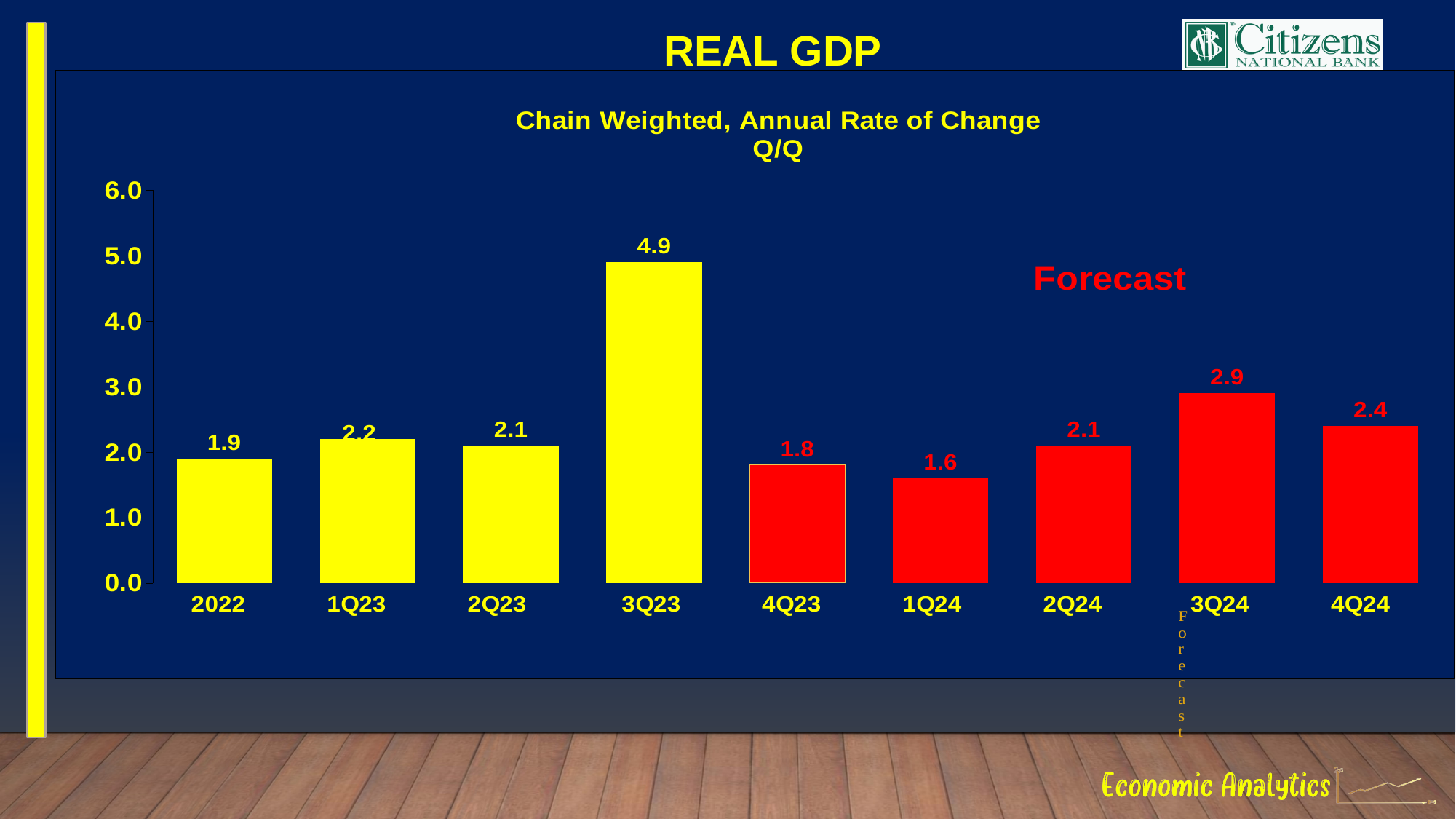
Which category has the highest value? 3Q23 Which is larger, the value for 3Q24 or the value for 4Q24? 3Q24 What kind of chart is shown? bar chart Do the values rise or fall from 1Q24 to 3Q24? rise What is the subtitle shown above the chart? Chain Weighted, Annual Rate of Change Q/Q Is the value for 3Q23 greater or less than 4.0? greater How many categories are shown on the x axis? 9 What is the difference between the values for 3Q23 and 4Q23? 3.1 What is the value for 1Q24? 1.6 What is the value for 3Q23? 4.9 What is the value for 2022? 1.9 Which category has the lowest value? 1Q24